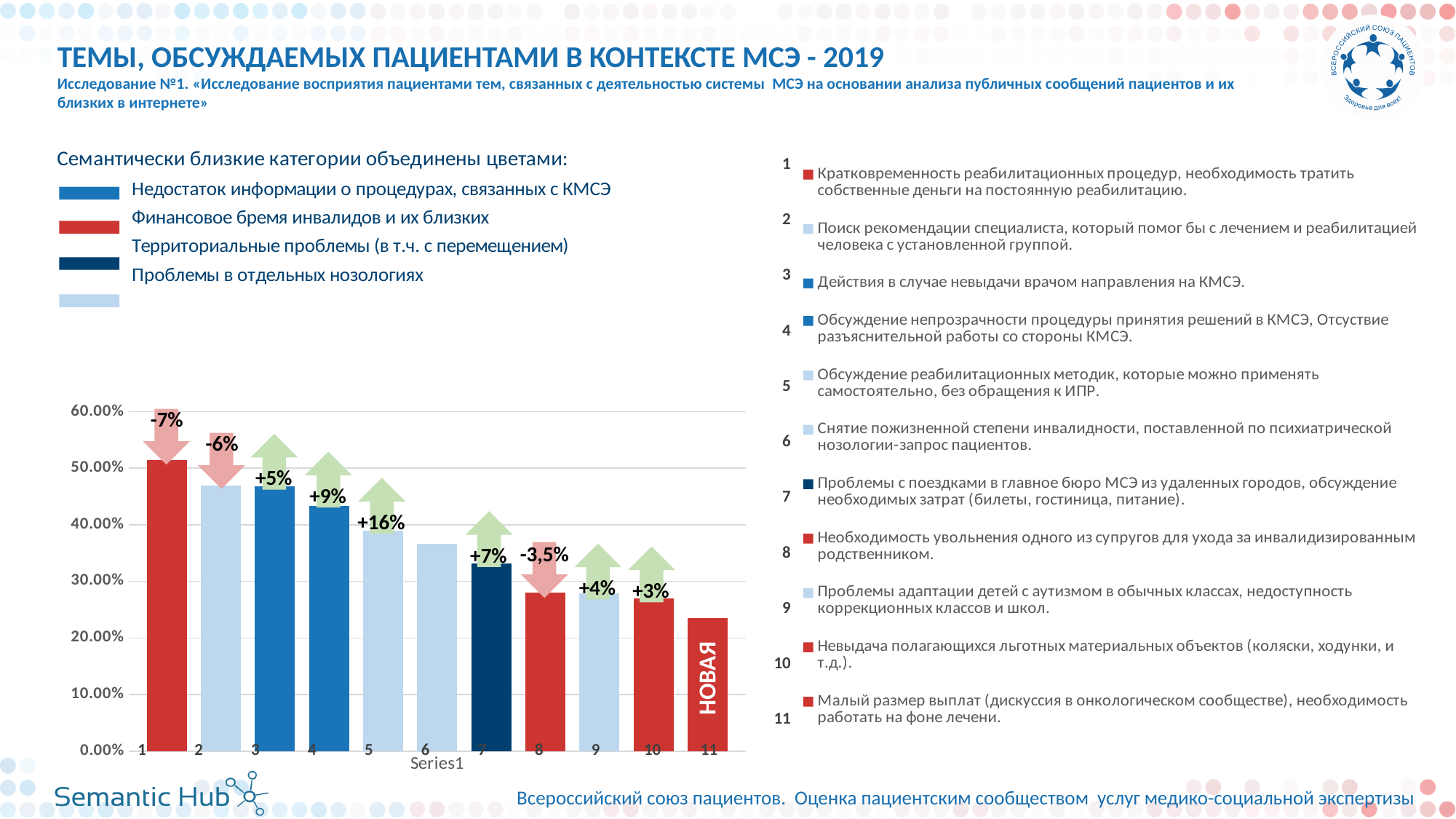
Which category has the tallest bar in the chart? 1 Is the value for category 8 greater or less than 30.00%? less Which is larger, the value for category 4 or the value for category 7? category 4 How many bars (categories) are plotted in the chart? 11 Is the value for category 1 greater or less than 50.00%? greater What change percentage is printed on the arrow above the bar for category 5? +16% What word is written on the bar for category 11? НОВАЯ Which category has the shortest bar in the chart? 11 Is the value for category 5 greater or less than 40.00%? less What kind of chart is shown on the slide? bar chart Do the bar values generally rise or fall from category 1 to category 11? fall